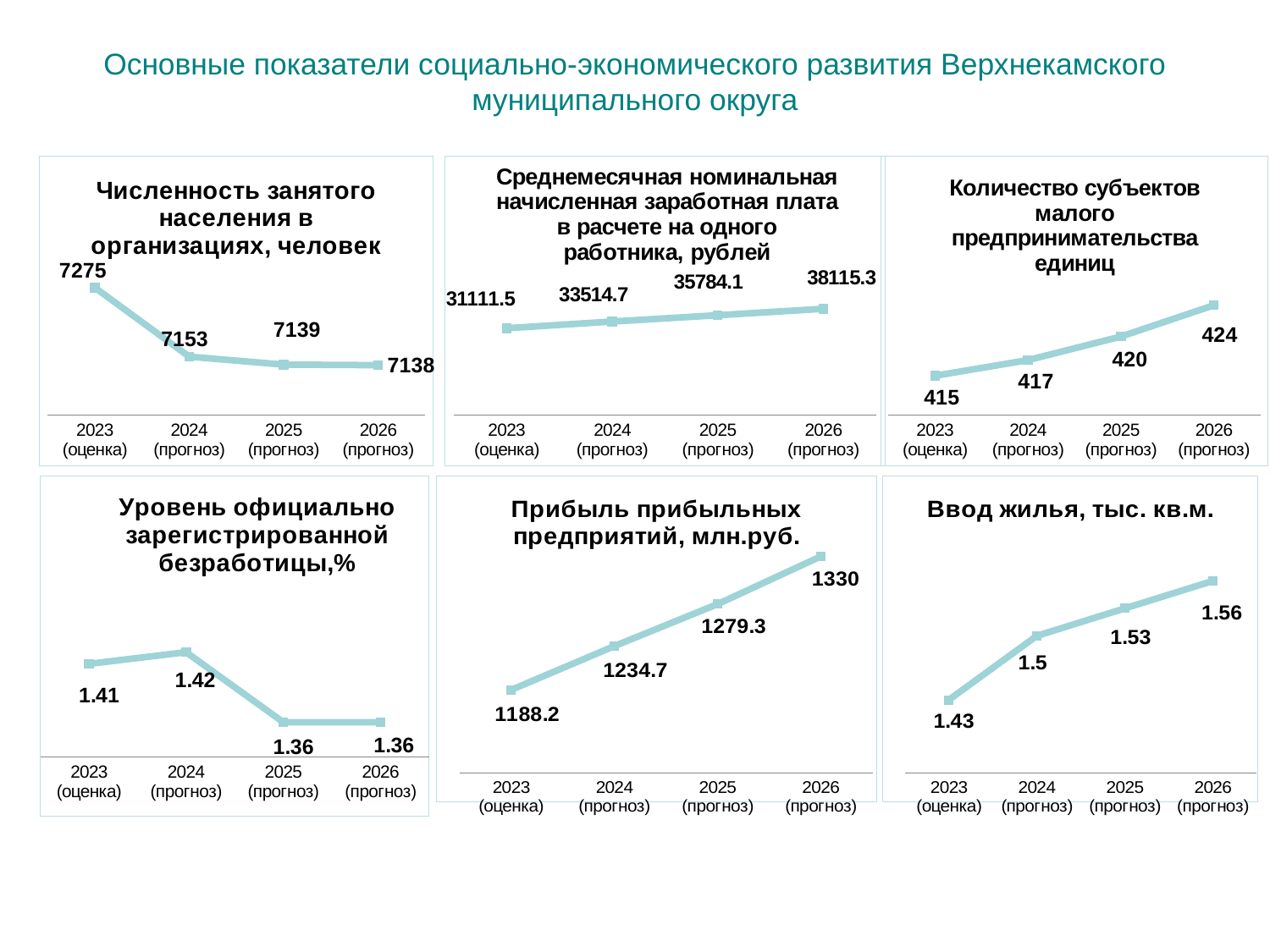
In the chart titled "Среднемесячная номинальная начисленная заработная плата в расчете на одного работника, рублей", what is the value for 2026 (прогноз)? 38115.3 In the chart titled "Численность занятого населения в организациях, человек", what is the difference between the values for 2023 (оценка) and 2024 (прогноз)? 122 In the chart titled "Количество субъектов малого предпринимательства единиц", which is larger: the value for 2024 (прогноз) or the value for 2025 (прогноз)? 2025 (прогноз) In the chart titled "Прибыль прибыльных предприятий, млн.руб.", which year has the lowest value? 2023 (оценка) In the chart titled "Количество субъектов малого предпринимательства единиц", which year has the highest value? 2026 (прогноз) In the chart titled "Численность занятого населения в организациях, человек", what is the value for 2023 (оценка)? 7275 What kind of chart is the chart titled "Среднемесячная номинальная начисленная заработная плата в расчете на одного работника, рублей"? line chart In the chart titled "Уровень официально зарегистрированной безработицы,%", which year has the highest value? 2024 (прогноз) In the chart titled "Численность занятого населения в организациях, человек", do the values rise or fall from 2023 to 2026? fall In the chart titled "Прибыль прибыльных предприятий, млн.руб.", do the values rise or fall from 2023 to 2026? rise In the chart titled "Ввод жилья, тыс. кв.м.", what is the difference between the values for 2026 (прогноз) and 2023 (оценка)? 0.13 How many data points are plotted in the chart titled "Ввод жилья, тыс. кв.м."? 4